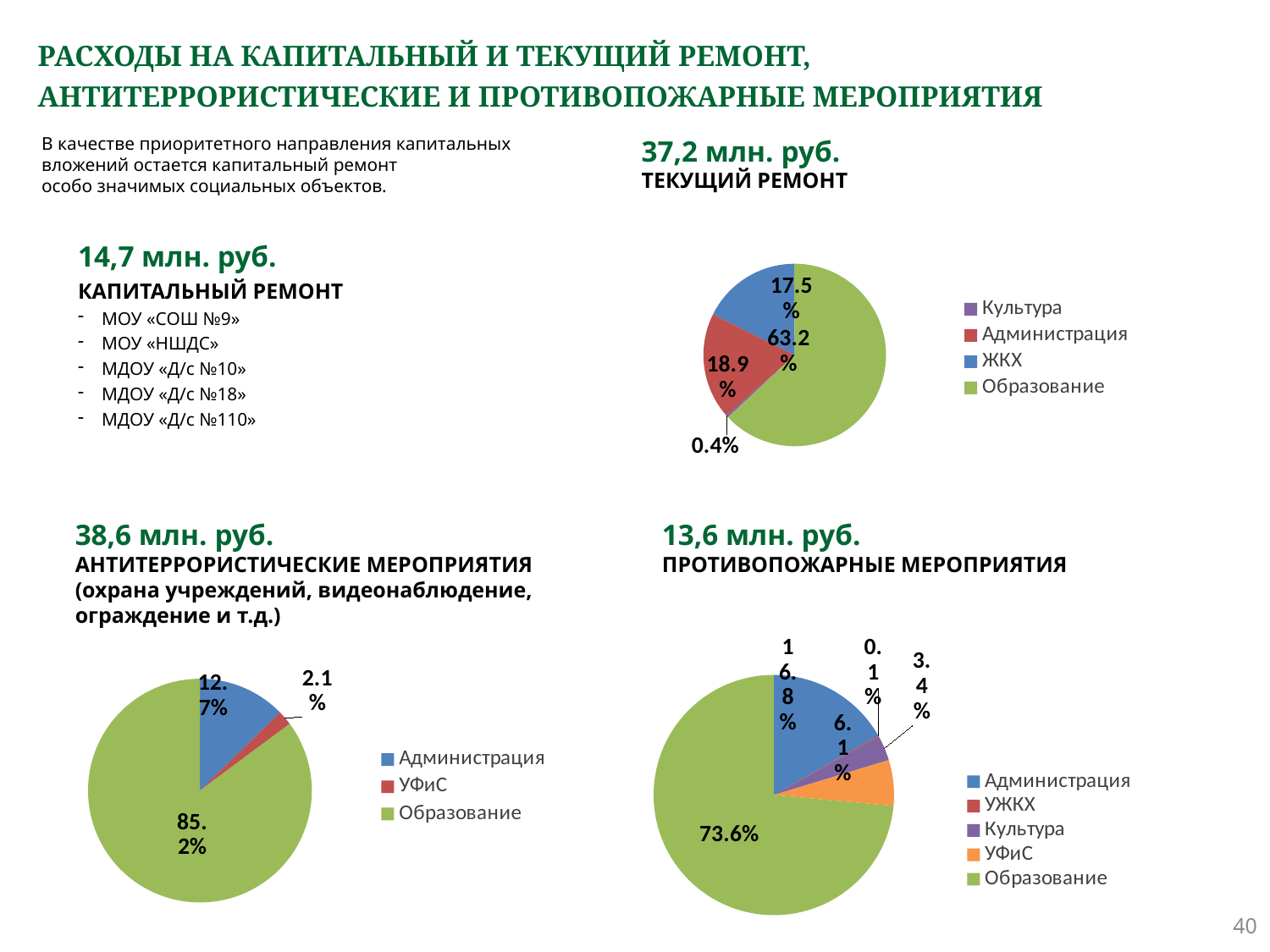
What type of chart is used for ПРОТИВОПОЖАРНЫЕ МЕРОПРИЯТИЯ? Pie chart In the ПРОТИВОПОЖАРНЫЕ МЕРОПРИЯТИЯ pie chart, how many categories does the legend list? 5 In the ПРОТИВОПОЖАРНЫЕ МЕРОПРИЯТИЯ pie chart, what share does Образование have? 73.6% In the АНТИТЕРРОРИСТИЧЕСКИЕ МЕРОПРИЯТИЯ pie chart, what share does УФиС have? 2.1% In the ТЕКУЩИЙ РЕМОНТ pie chart, how many categories does the legend list? 4 In the ТЕКУЩИЙ РЕМОНТ pie chart, what share does Образование have? 63.2% In the ТЕКУЩИЙ РЕМОНТ pie chart, which category has the smallest share? Культура In the ТЕКУЩИЙ РЕМОНТ pie chart, what is the difference between the shares of Администрация and ЖКХ? 1.4% In the ТЕКУЩИЙ РЕМОНТ pie chart, what share does Администрация have? 18.9% In the ПРОТИВОПОЖАРНЫЕ МЕРОПРИЯТИЯ pie chart, which is larger, the share of Администрация or the share of УФиС? Администрация In the АНТИТЕРРОРИСТИЧЕСКИЕ МЕРОПРИЯТИЯ pie chart, which category has the largest share? Образование In the АНТИТЕРРОРИСТИЧЕСКИЕ МЕРОПРИЯТИЯ pie chart, what share does Администрация have? 12.7%